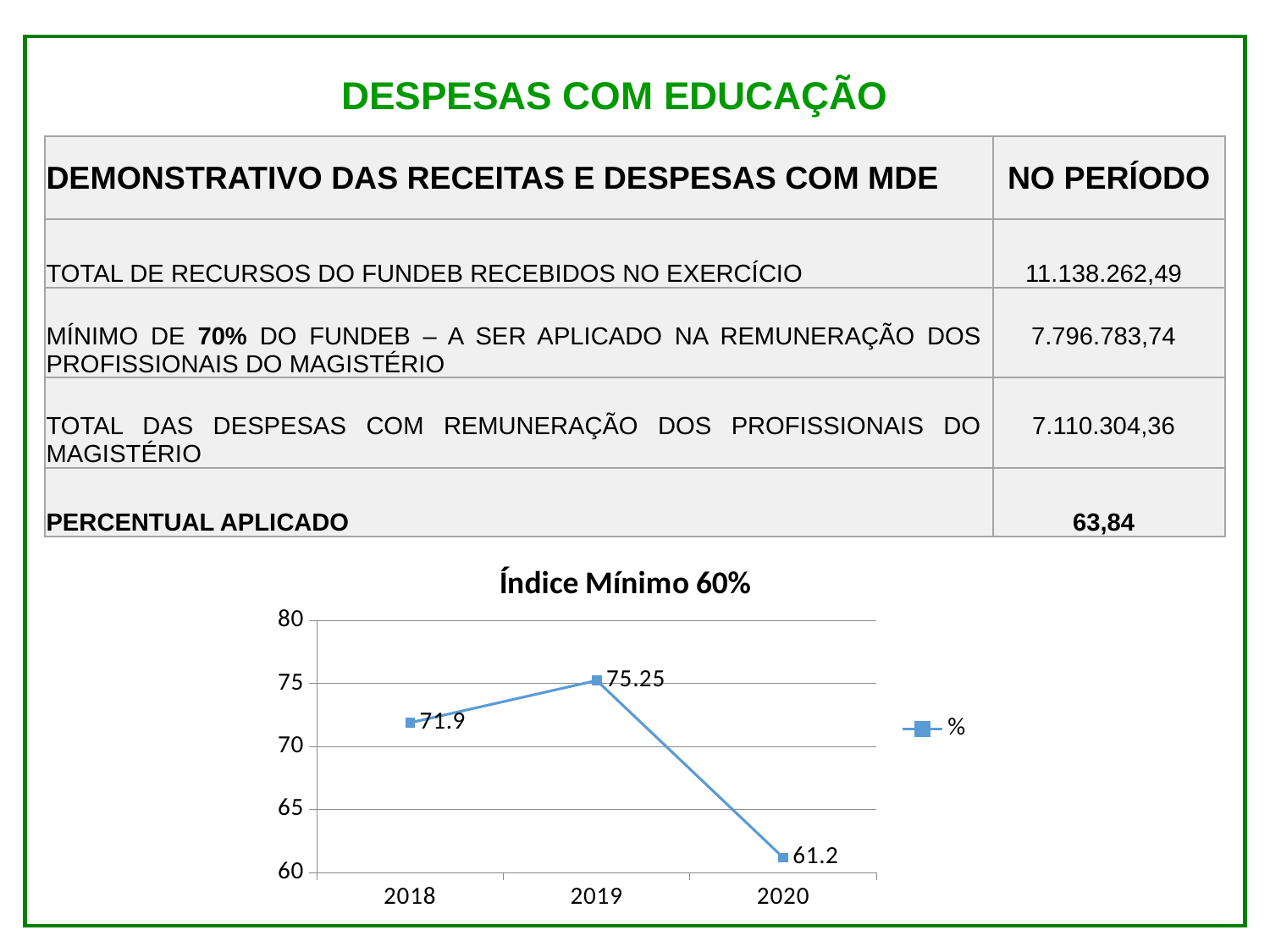
Is the value for 2020 greater or less than 65? less What is the difference between the values for 2019 and 2018? 3.35 What is the value for 2020 in the chart? 61.2 How many years are plotted in the chart? 3 Which is larger, the value for 2018 or the value for 2020? 2018 What is the value for 2018 in the chart? 71.9 What is the value for 2019 in the chart? 75.25 Which year has the lowest value in the chart? 2020 What is the difference between the values for 2019 and 2020? 14.05 Which year has the highest value in the chart? 2019 What is the title of the chart? Índice Mínimo 60% What kind of chart is shown on the slide? line chart